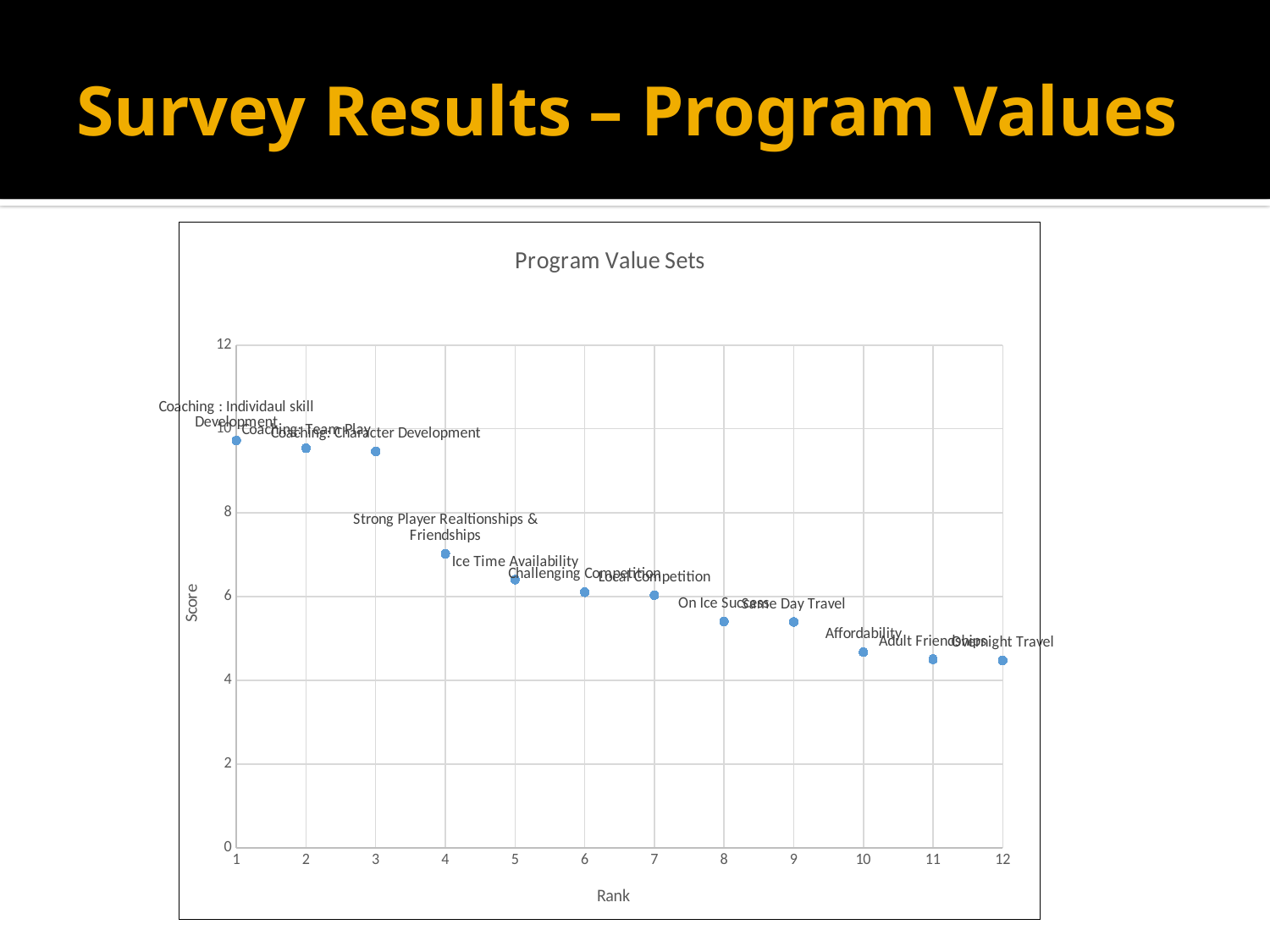
Is the score for Strong Player Relationships & Friendships greater or less than 8? less Which program value has the highest score? Coaching : Individaul skill Development What kind of chart is shown on the slide? scatter chart What is the label of the x axis? Rank What is the title of the chart? Program Value Sets Is the score for Coaching: Team Play greater or less than 8? greater Is the score for Affordability greater or less than 4? greater Which has a higher score, Coaching: Character Development or Overnight Travel? Coaching: Character Development How many data points are plotted in the chart? 12 Do the scores rise or fall as rank increases along the x axis? fall Which has a higher score, Strong Player Relationships & Friendships or On Ice Success? Strong Player Relationships & Friendships